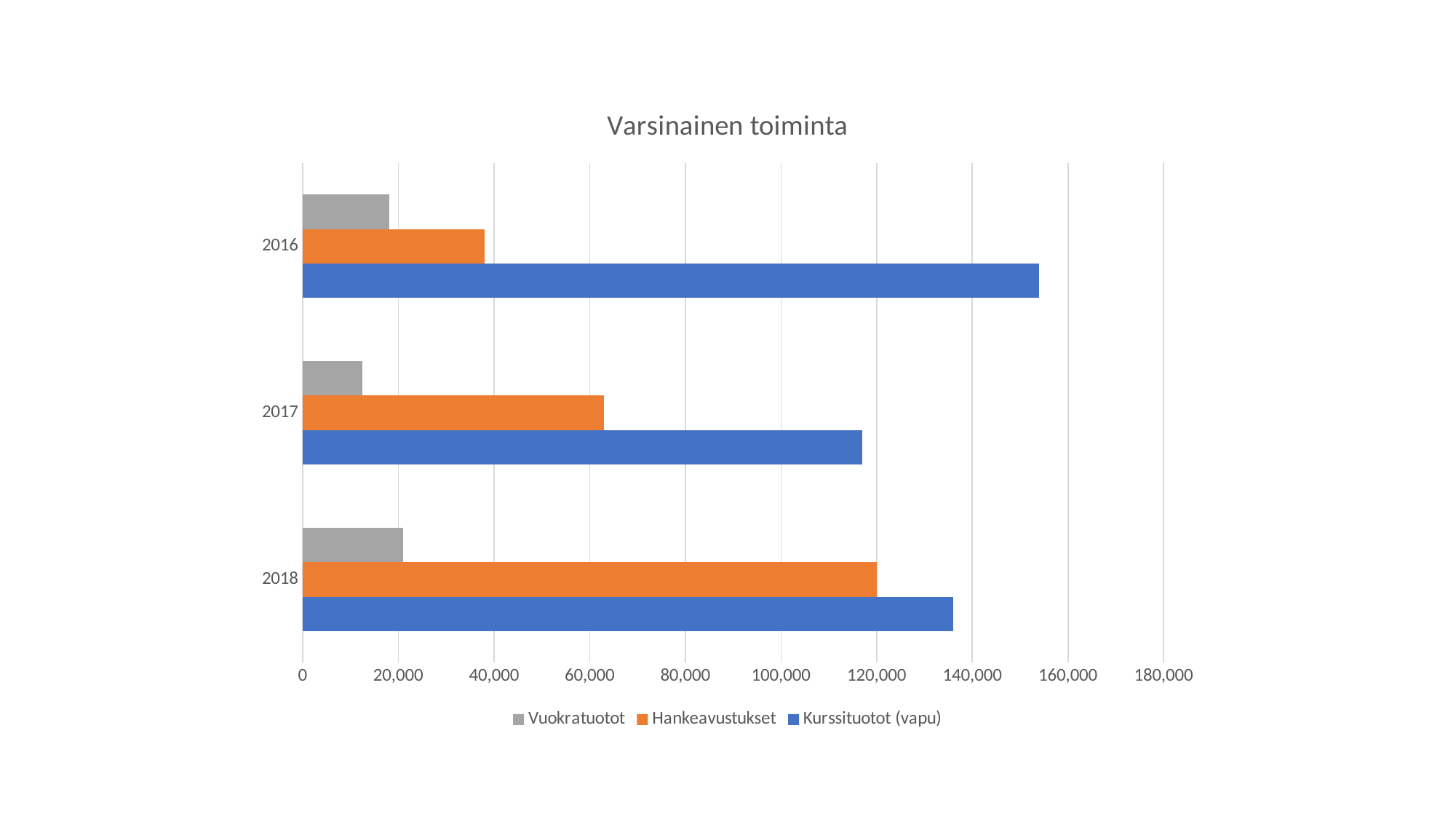
Which year has the lowest value for Vuokratuotot? 2017 Do the values for Hankeavustukset rise or fall from 2016 to 2018? rise Is the value for Vuokratuotot in 2018 greater or less than 40,000? less What colour are the bars for Kurssituotot (vapu)? Blue Is the value for Kurssituotot (vapu) in 2016 greater or less than 140,000? greater What is the title of the chart? Varsinainen toiminta Is the value for Hankeavustukset in 2017 greater or less than 80,000? less What kind of chart is shown on the slide? Bar chart In 2018, which is larger: Hankeavustukset or Kurssituotot (vapu)? Kurssituotot (vapu) Which year has the highest value for Kurssituotot (vapu)? 2016 How many series does the legend list? 3 How many years are shown on the vertical axis? 3